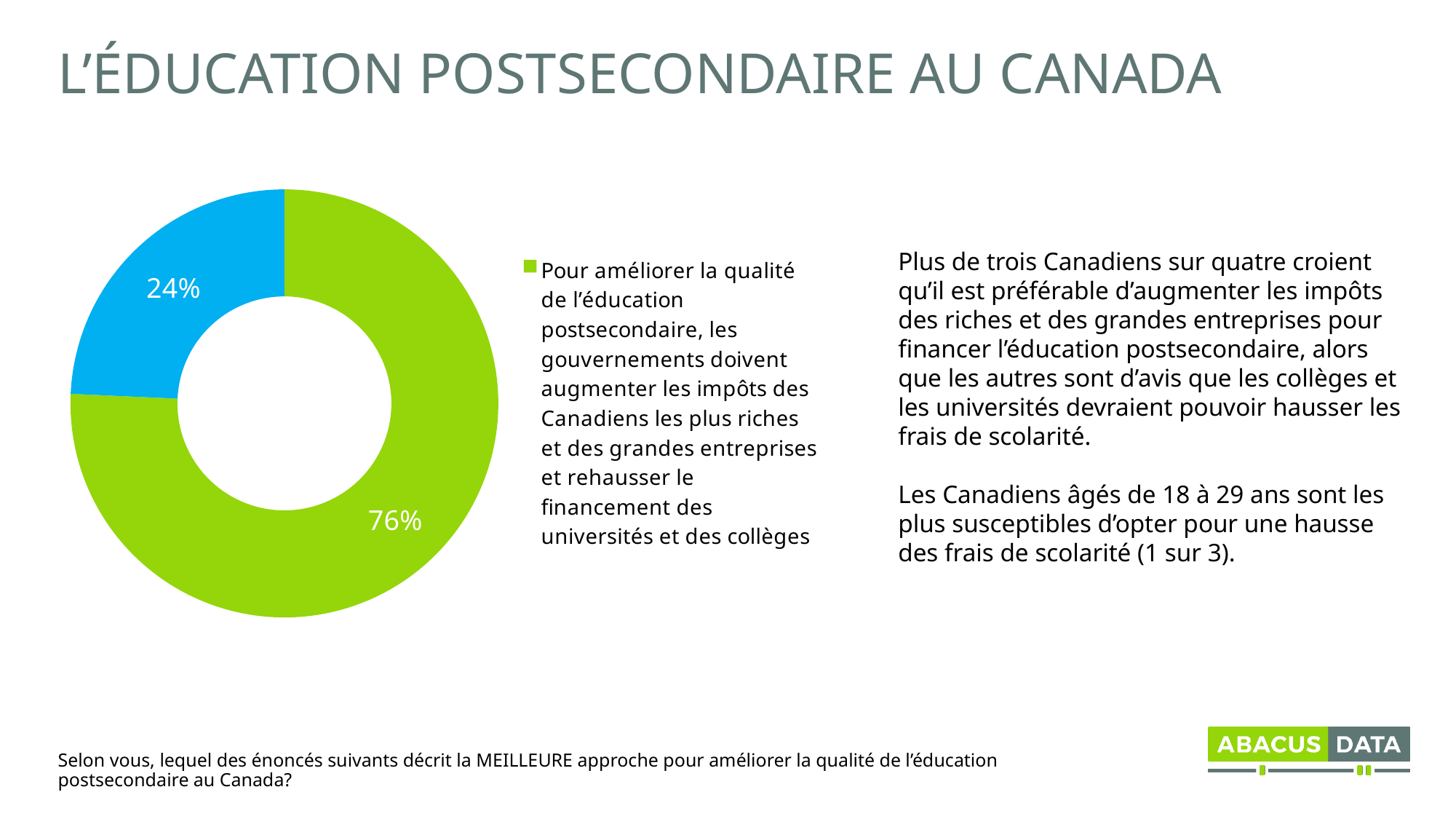
How many entries does the chart legend list? 1 What percentage is shown for the blue slice of the donut chart? 24% Which slice of the donut chart is the smallest? The blue slice (24%) Is the green slice or the blue slice larger? The green slice How many slices does the donut chart have? 2 Which slice of the donut chart is the largest? The green slice (76%) What is the difference in percentage points between the green slice and the blue slice? 52 percentage points What kind of chart is shown on the slide? Pie chart (donut) What share of the whole does the green slice represent? 76% What colour is the slice labelled 24%? Blue What is the title of the slide containing the chart? L'ÉDUCATION POSTSECONDAIRE AU CANADA What percentage is shown for the green slice, labelled in the legend as the option that governments should raise taxes on the richest Canadians and large corporations to fund universities and colleges? 76%